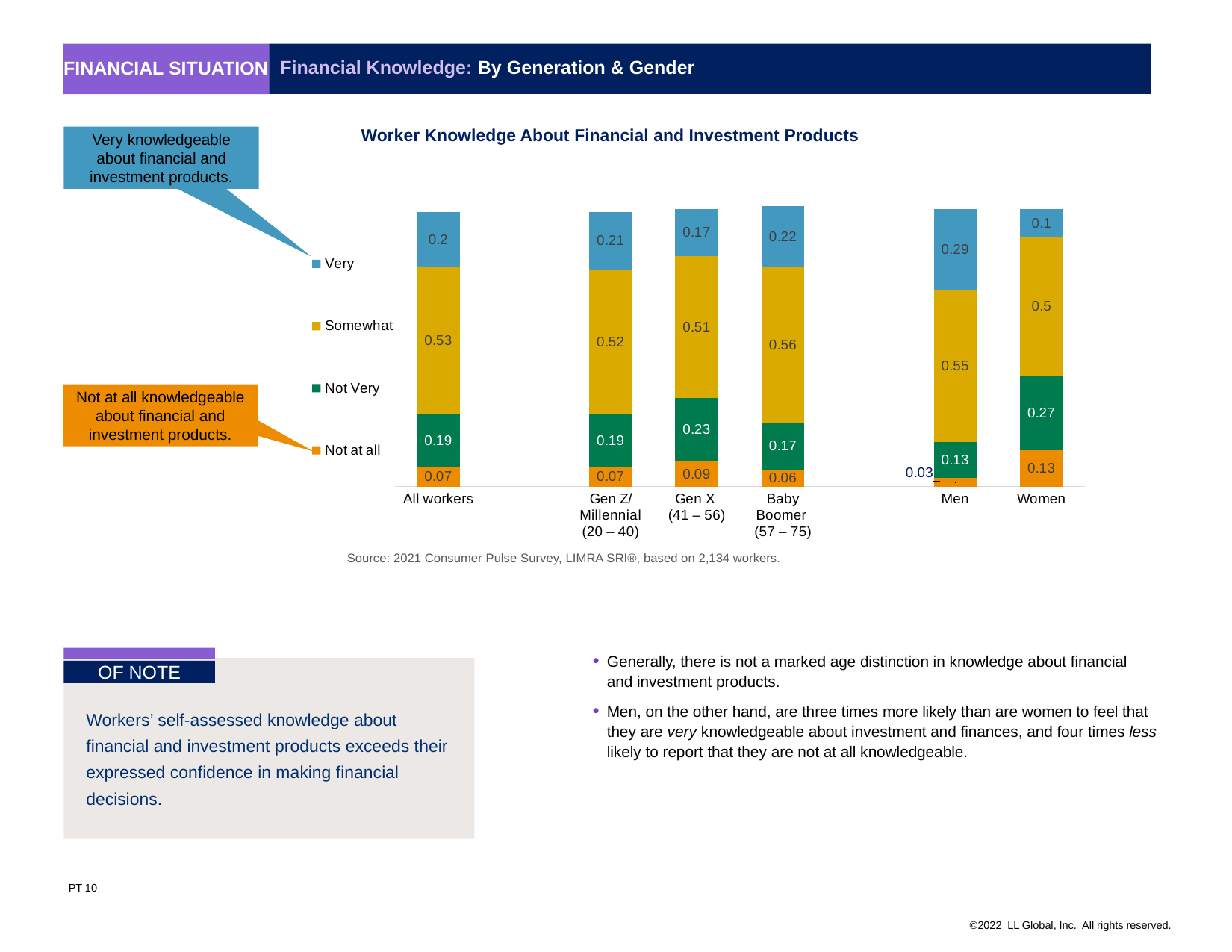
What is the Not at all value for Women? 0.13 Which category has the highest Very value? Men How many categories are shown on the x axis? 6 What is the value for Very among Men? 0.29 What is the difference between the Very value for Men and the Very value for Women? 0.19 Which has the larger Somewhat value, Gen X (41 – 56) or Baby Boomer (57 – 75)? Baby Boomer (57 – 75) What is the Not Very value for Gen X (41 – 56)? 0.23 How many series does the legend list? 4 Which category has the lowest Very value? Women What is the total of the stacked bar for Women? 1 What is the Somewhat value for Baby Boomer (57 – 75)? 0.56 What kind of chart is shown? Stacked bar chart